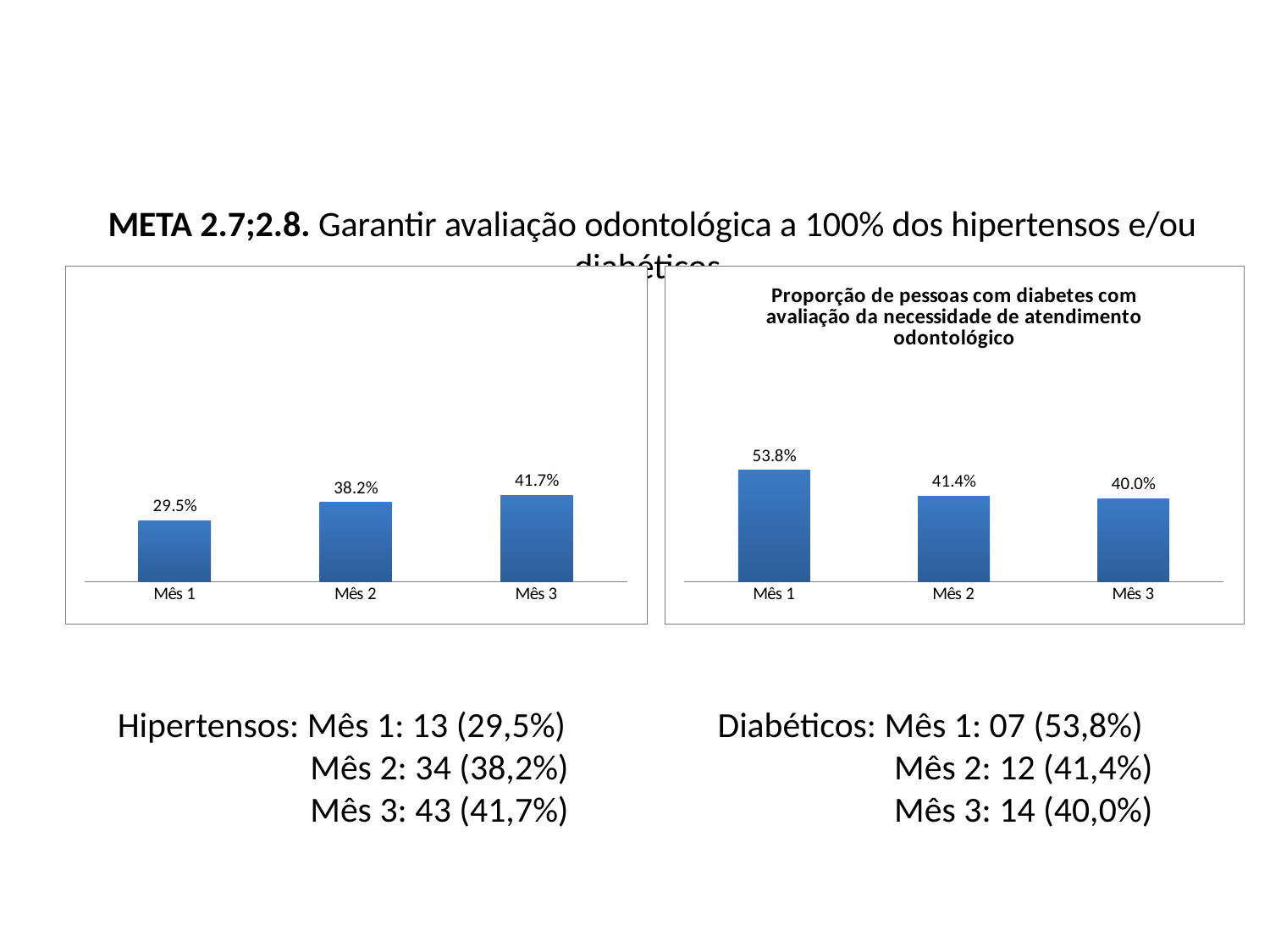
In the left chart, what is the difference between the values for Mês 3 and Mês 1? 12.2% In the right chart (Proporção de pessoas com diabetes com avaliação da necessidade de atendimento odontológico), which month has the lowest value? Mês 3 In the left chart, which month has the highest value? Mês 3 In the left chart, do the values rise or fall from Mês 1 to Mês 3? rise In the left chart, what is the value for Mês 3? 41.7% In the left chart, which is larger, the value for Mês 2 or the value for Mês 1? Mês 2 In the left chart, what is the value for Mês 1? 29.5% In the right chart (Proporção de pessoas com diabetes com avaliação da necessidade de atendimento odontológico), what is the value for Mês 1? 53.8% What kind of chart is the left chart? bar chart In the right chart (Proporção de pessoas com diabetes com avaliação da necessidade de atendimento odontológico), what is the difference between the values for Mês 1 and Mês 2? 12.4% How many categories are shown on the x axis of the right chart (Proporção de pessoas com diabetes com avaliação da necessidade de atendimento odontológico)? 3 In the right chart (Proporção de pessoas com diabetes com avaliação da necessidade de atendimento odontológico), what is the value for Mês 2? 41.4%